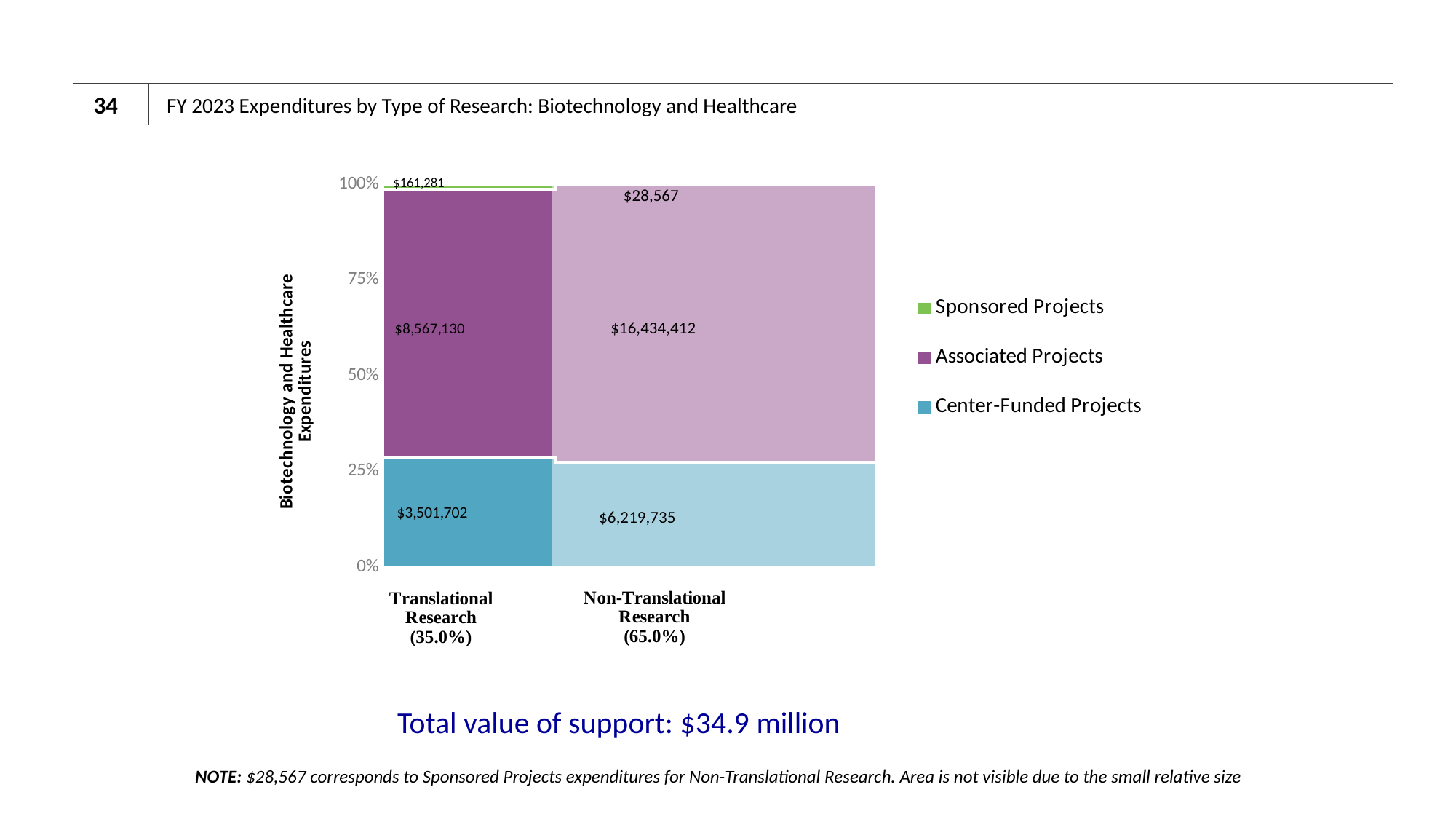
How many series does the legend list? 3 What is the Sponsored Projects expenditure for Non-Translational Research? $28,567 What is the Sponsored Projects expenditure for Translational Research? $161,281 What is the difference between the Associated Projects expenditures for Non-Translational Research and Translational Research? $7,867,282 What is the total expenditure for the Non-Translational Research bar? $22,682,714 Which research type has the larger Associated Projects expenditure? Non-Translational Research What is the Associated Projects expenditure for Translational Research? $8,567,130 What is the Center-Funded Projects expenditure for Non-Translational Research? $6,219,735 What percentage share is shown for Non-Translational Research on the x axis? 65.0% What kind of chart is shown on the slide? Stacked bar chart What is the difference between the Center-Funded Projects expenditures for Non-Translational Research and Translational Research? $2,718,033 What is the total expenditure for the Translational Research bar? $12,230,113